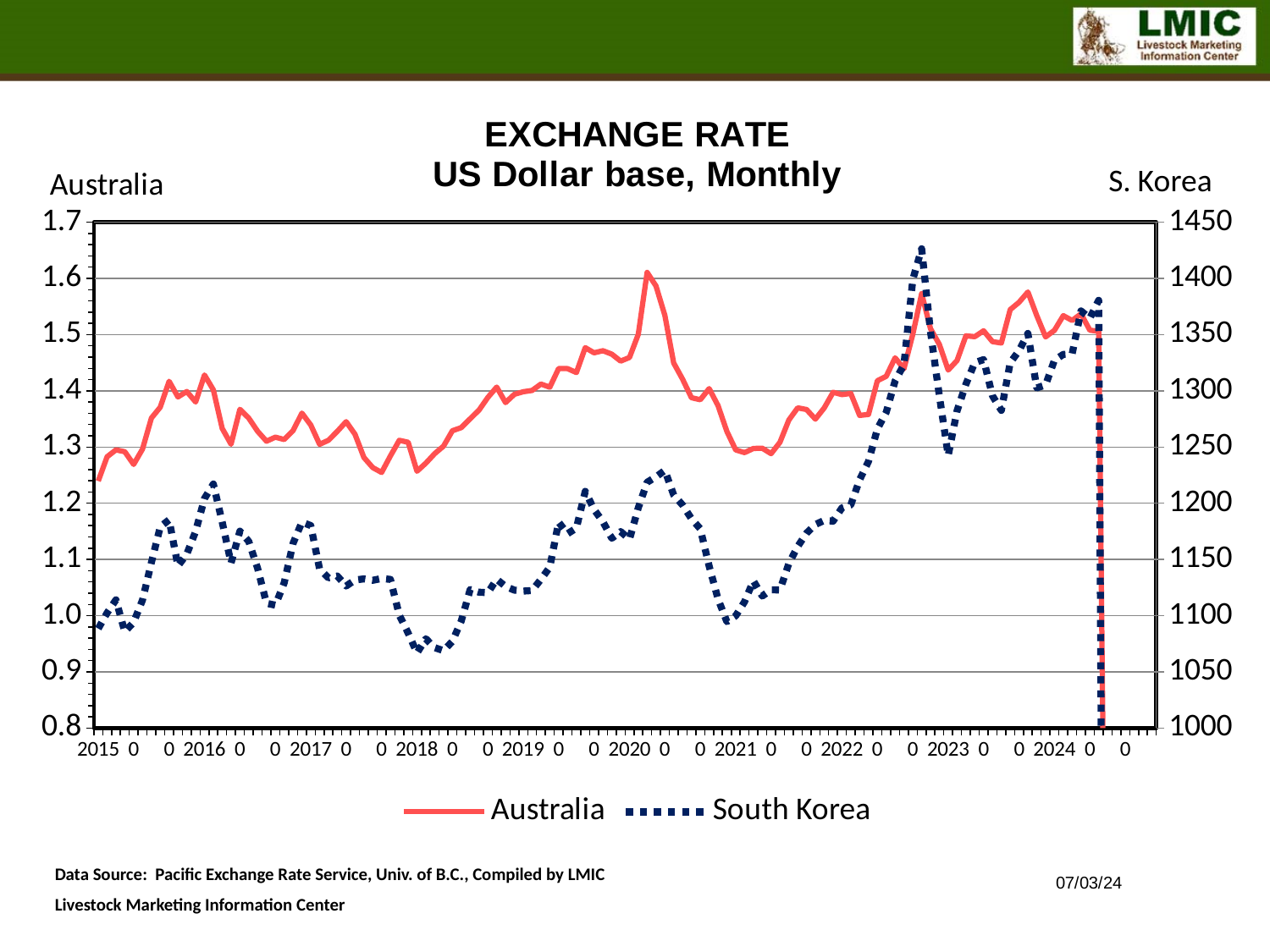
What kind of chart is shown on the slide? line chart What is the title of the chart? EXCHANGE RATE US Dollar base, Monthly Is the South Korea low point in 2018 greater or less than 1100? less Is the South Korea low point in 2021 greater or less than 1150? less Is the Australia value at the start of 2015 greater or less than 1.3? less Which series is plotted against the right-hand axis labelled 1000 to 1450? South Korea How many series does the legend list? 2 Overall, does the Australia series rise or fall from 2015 to 2024? rise